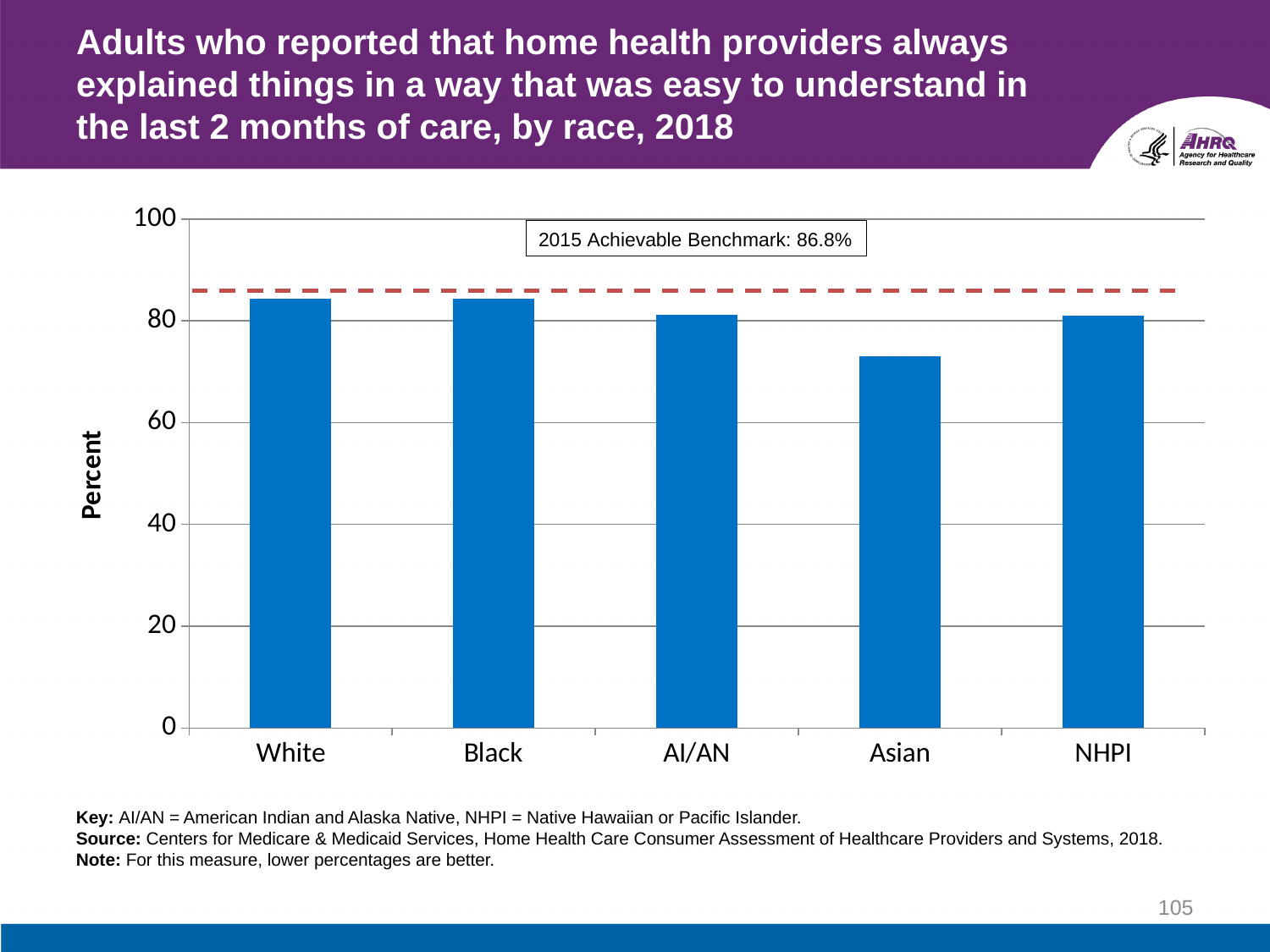
Which is larger, the value for White or the value for Asian? White Which is larger, the value for Asian or the value for NHPI? NHPI Is the value for NHPI greater or less than 60? greater Is the value for Asian greater or less than 80? less Which racial group has the lowest percentage in the chart? Asian Is the value for White greater or less than 80? greater What is the label on the y axis of the chart? Percent How many racial groups are shown on the x axis of the chart? 5 What kind of chart is shown on the slide? bar chart What is the 2015 Achievable Benchmark shown on the chart? 86.8%